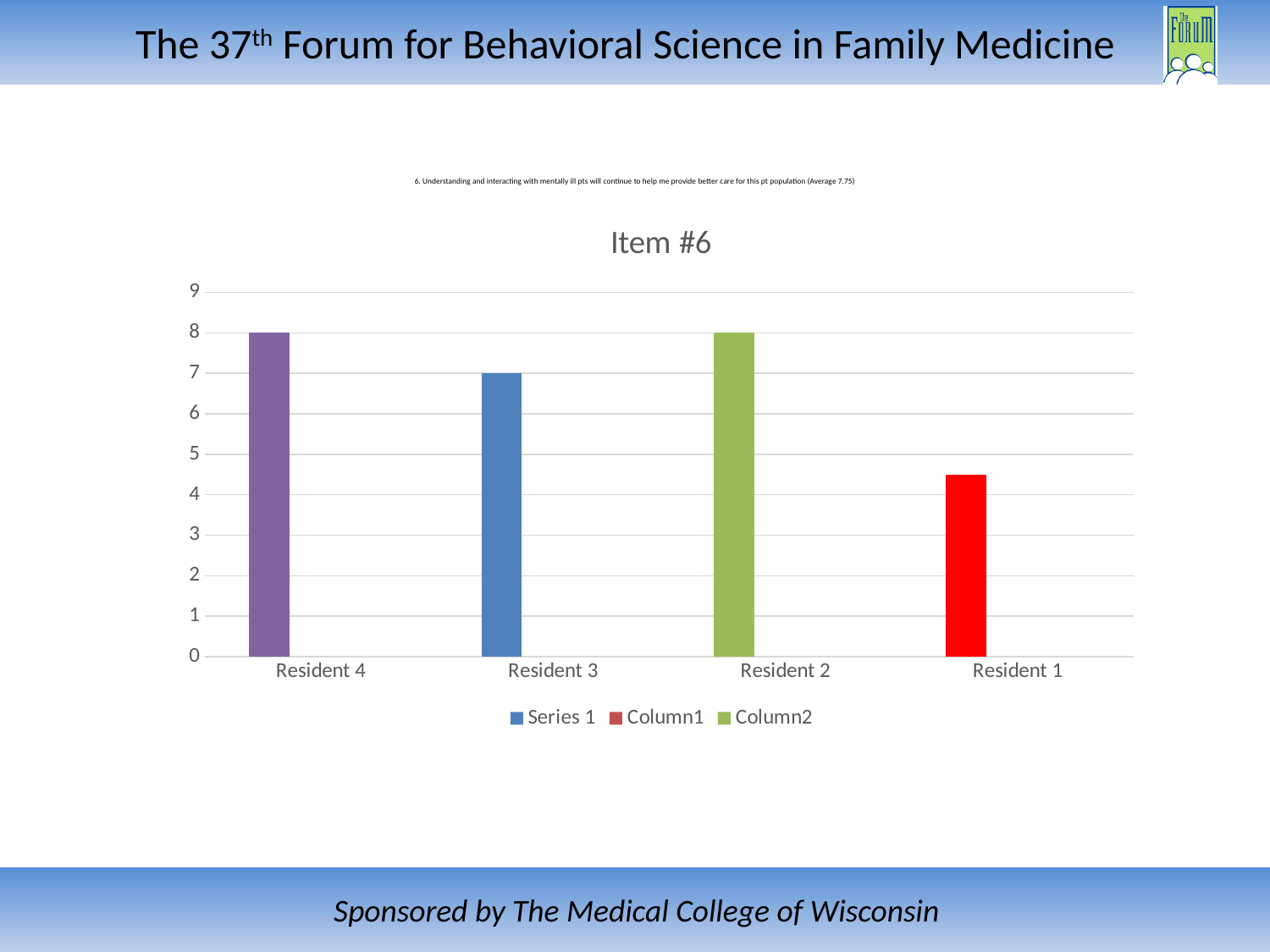
Which resident has the lowest value? Resident 1 What is the value for Resident 3? 7 What is the value for Resident 4? 8 What kind of chart is shown on the slide? bar chart Which is larger, the value for Resident 2 or the value for Resident 3? Resident 2 Is the value for Resident 1 greater or less than 5? less Is the value for Resident 1 greater or less than 4? greater How many entries does the legend list? 3 What is the value for Resident 2? 8 Which is larger, the value for Resident 3 or the value for Resident 1? Resident 3 What is the difference between the values for Resident 4 and Resident 3? 1 How many residents are shown on the x axis? 4